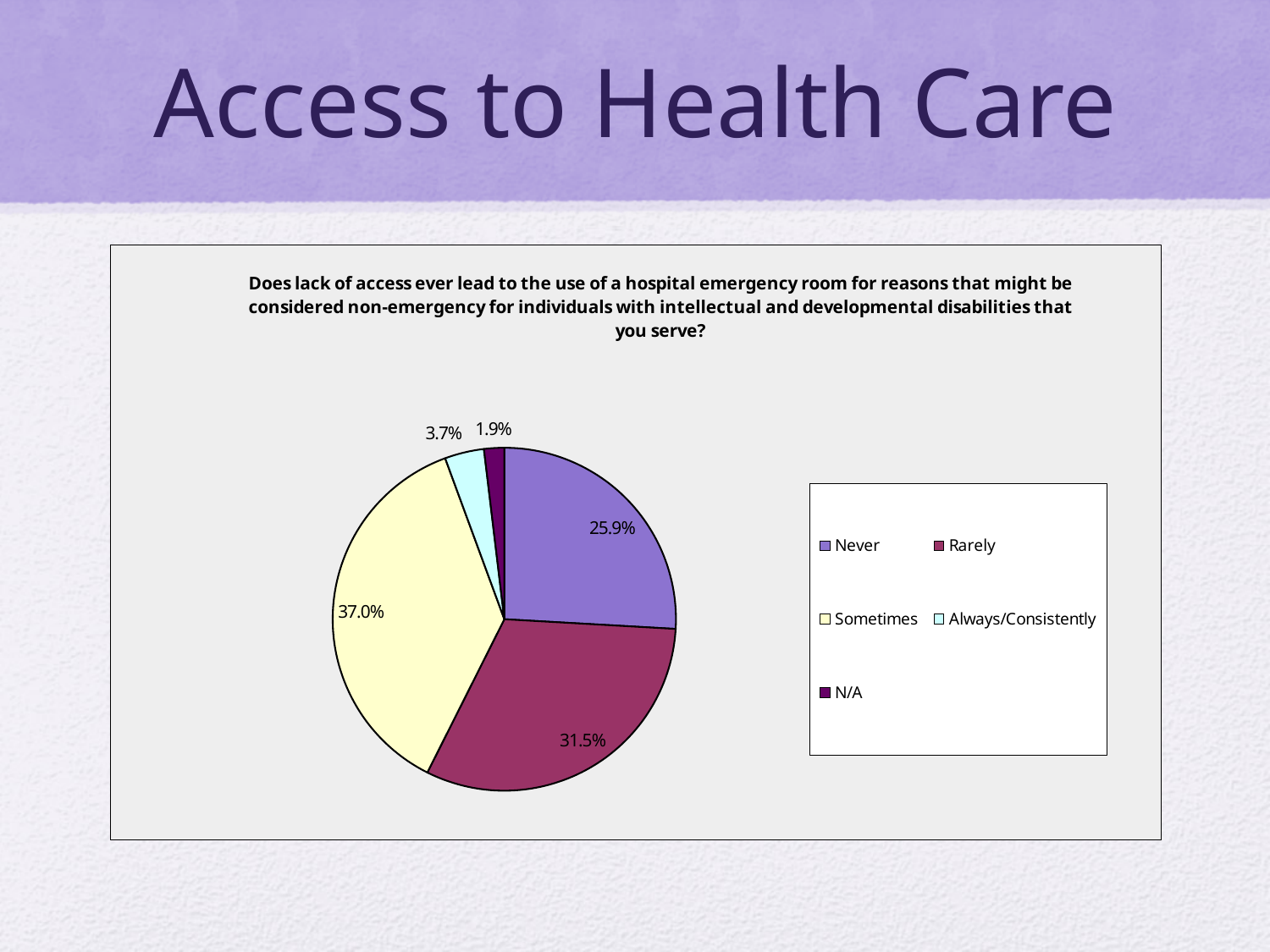
What kind of chart is shown on the slide? pie chart Which response category has the largest share of the pie? Sometimes What percentage of respondents answered "Rarely"? 31.5% How many slices does the pie chart have? 5 What is the difference in percentage points between the "Sometimes" and "Never" slices? 11.1 What percentage of respondents answered "Sometimes"? 37.0% Which slice is larger, "Rarely" or "Never"? Rarely What percentage of respondents answered "Always/Consistently"? 3.7% What percentage of respondents answered "Never"? 25.9% What colour is the "Sometimes" slice in the pie chart? light yellow What percentage is shown for the "N/A" slice? 1.9% Which response category has the smallest share of the pie? N/A